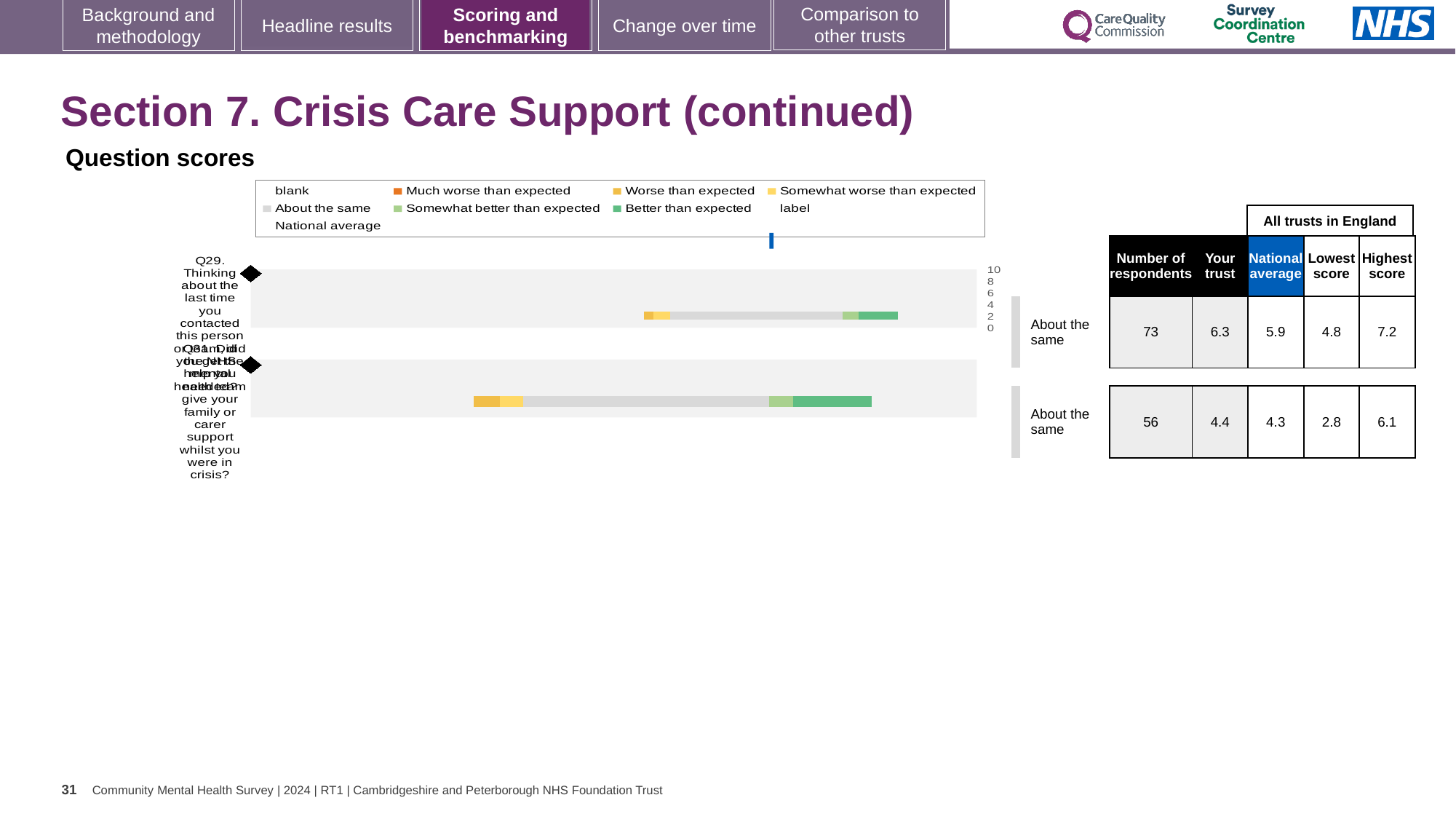
How many respondents answered Q29, according to the table beside the chart? 73 What is the lowest score among all trusts in England for Q31? 2.8 According to the table next to the chart, what is the 'Your trust' score for Q29? 6.3 What kind of chart is used to show the question scores on this slide? bar chart How many questions (bars) are plotted in the question scores chart? 2 What benchmark category is shown for both Q29 and Q31 next to the chart? About the same According to the table next to the chart, what is the national average score for Q31? 4.3 What is the highest score among all trusts in England for Q29? 7.2 What is the difference between the highest and lowest scores among all trusts in England for Q31? 3.3 Which of the two questions, Q29 or Q31, has the higher 'Your trust' score? Q29 How many respondents answered Q31, according to the table beside the chart? 56 For Q29, which is larger: the 'Your trust' score or the national average? Your trust